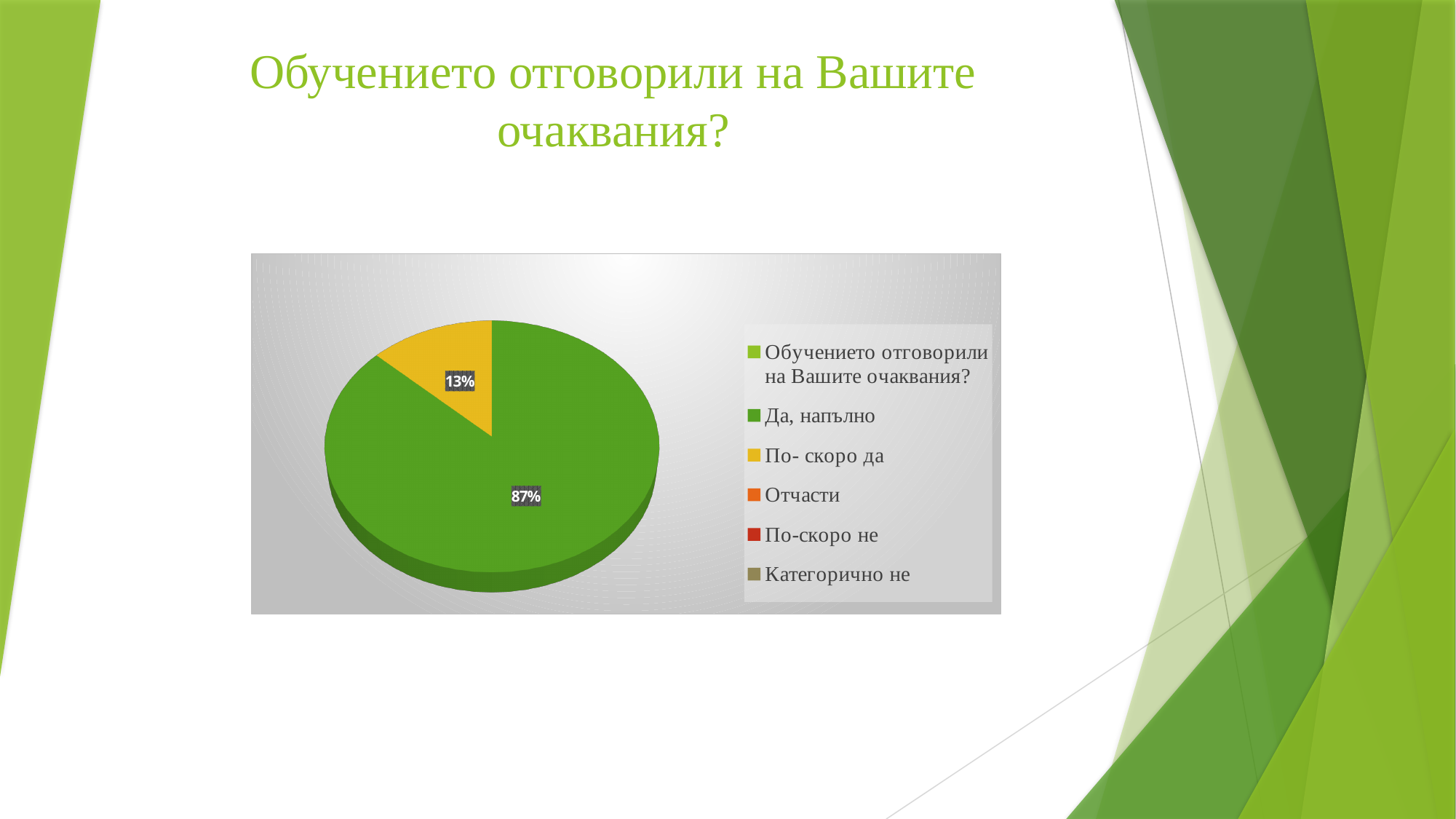
By how many percentage points does the "Да, напълно" slice exceed the "По- скоро да" slice? 74 percentage points Which is larger: the slice for "Да, напълно" or the slice for "По- скоро да"? Да, напълно What percentage of the pie is labelled for "Да, напълно"? 87% How many slices with data labels are visible in the pie? 2 How many entries does the legend list? 6 Which category has the largest slice of the pie? Да, напълно What share of the pie does the green slice represent? 87% What percentage of the pie is labelled for "По- скоро да"? 13% What colour is the slice for "По- скоро да"? Yellow What is the title of the slide? Обучението отговорили на Вашите очаквания? What kind of chart is shown on the slide? Pie chart Of the two slices shown in the pie, which is the smaller one? По- скоро да